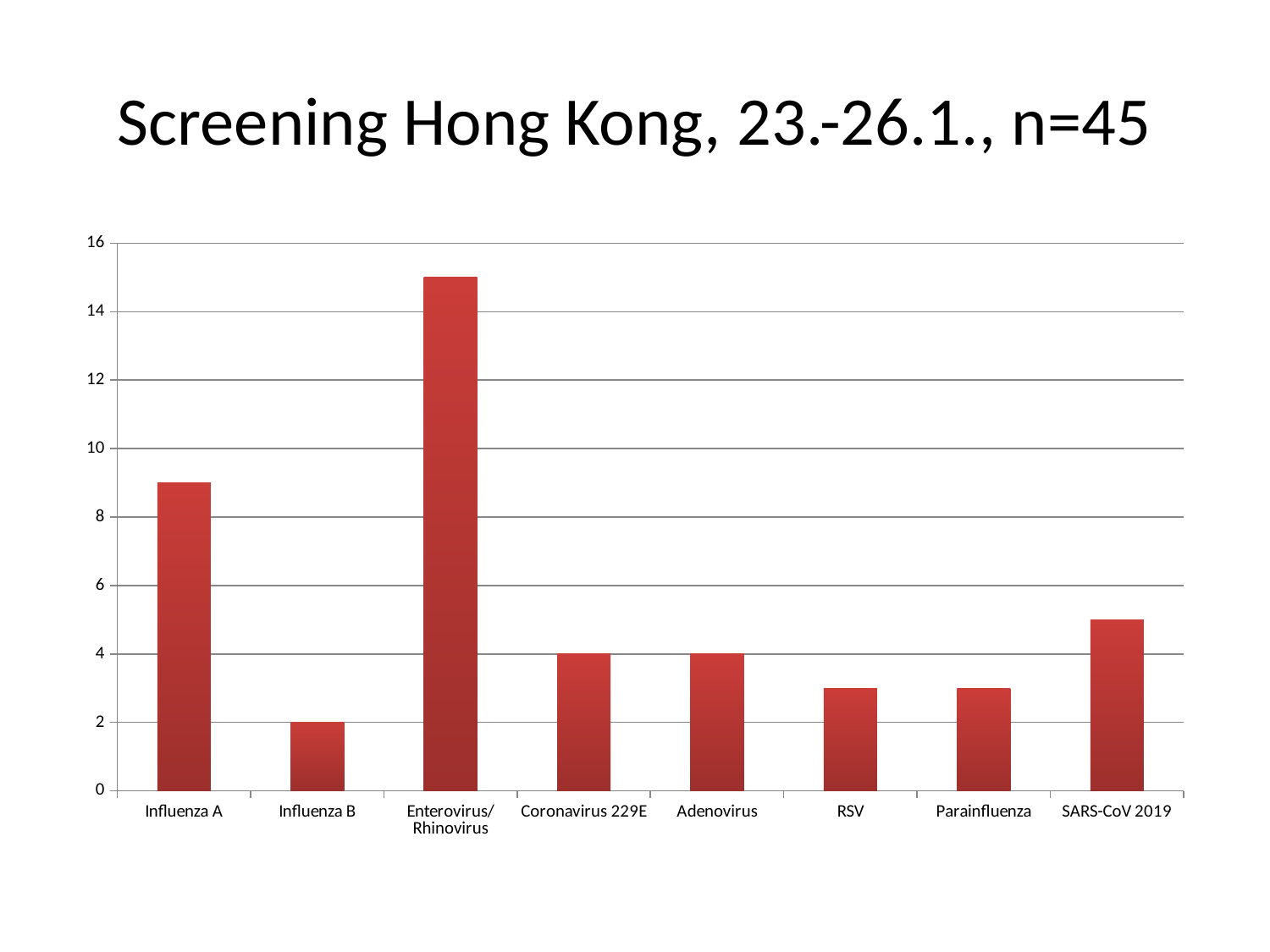
Which category has the lowest value? Influenza B Which is larger, the value for Influenza A or the value for SARS-CoV 2019? Influenza A What is the title of the chart? Screening Hong Kong, 23.-26.1., n=45 Which category has the highest value? Enterovirus/Rhinovirus What is the value for Influenza B? 2 How many categories are shown on the x axis? 8 What is the value for Adenovirus? 4 What type of chart is shown on the slide? bar chart What is the value for Coronavirus 229E? 4 Is the value for Influenza A greater or less than 8? greater What is the difference between the values for Coronavirus 229E and Influenza B? 2 Is the value for Enterovirus/Rhinovirus greater or less than 14? greater